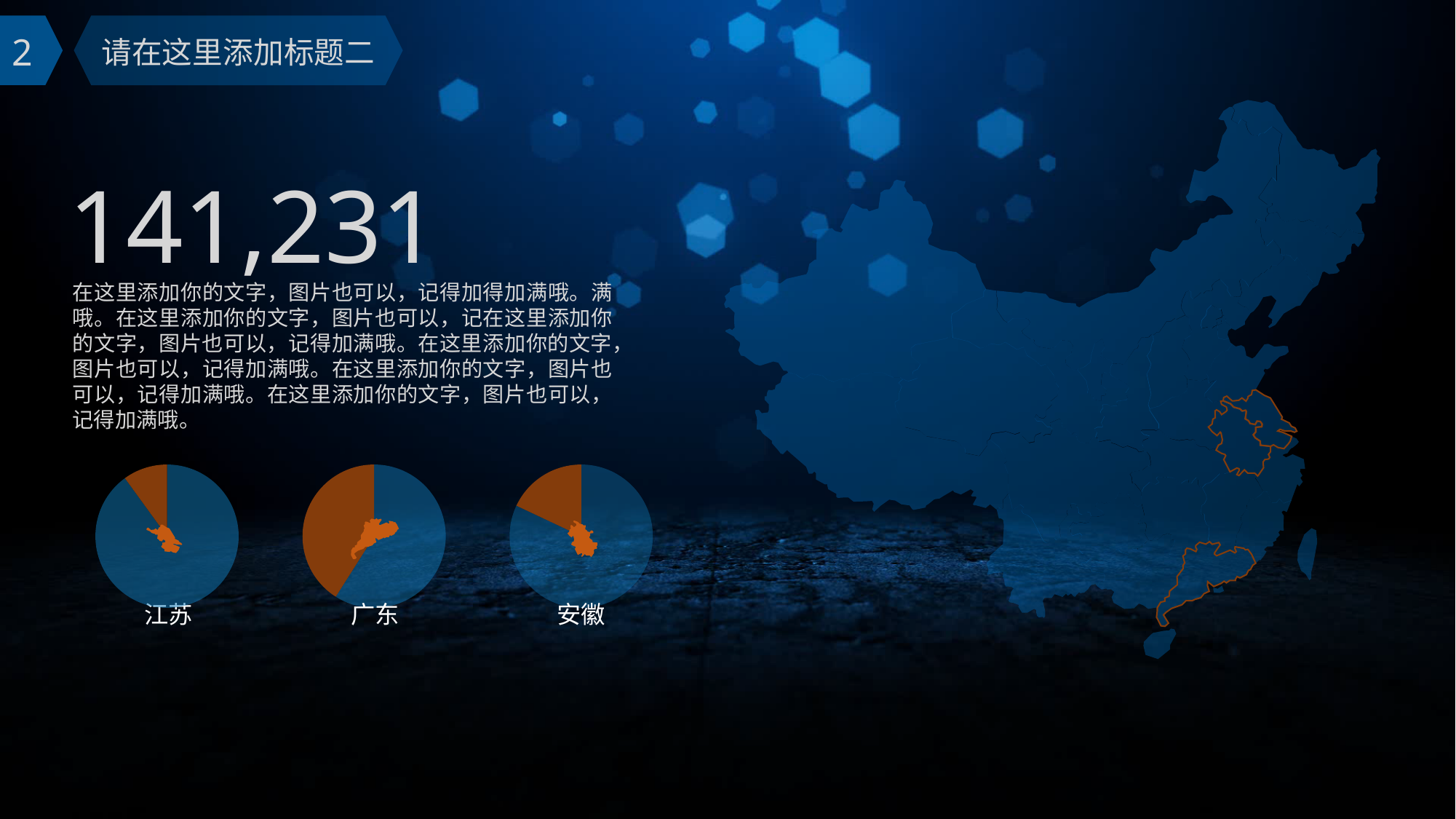
Which pie chart has the largest orange slice: 江苏, 广东 or 安徽? 广东 How many pie charts are shown on the slide? 3 Is the orange slice larger in the 广东 pie chart or in the 安徽 pie chart? 广东 Is the orange slice larger in the 安徽 pie chart or in the 江苏 pie chart? 安徽 What is the label under the leftmost pie chart? 江苏 What is the label under the rightmost pie chart? 安徽 What kind of charts are shown at the bottom left of the slide? Pie charts Which pie chart has the smallest orange slice: 江苏, 广东 or 安徽? 江苏 Is the orange slice larger in the 广东 pie chart or in the 江苏 pie chart? 广东